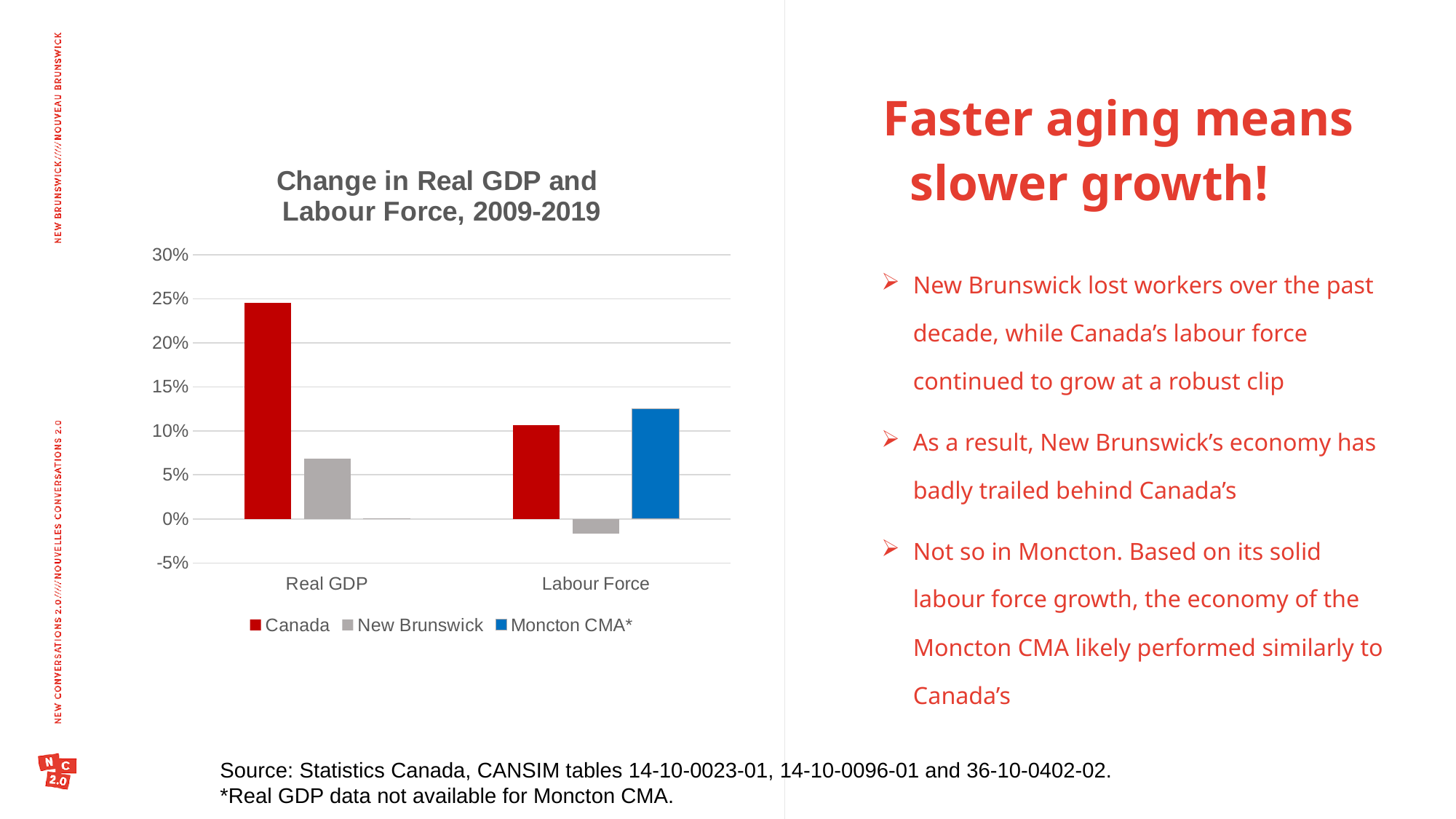
Is the value for Moncton CMA* in Labour Force greater or less than 10%? greater Which series has the lowest value in the Labour Force category? New Brunswick Is the value for New Brunswick in Real GDP greater or less than 10%? less Which series is shown in blue in the chart? Moncton CMA* What kind of chart is shown on the slide? bar chart In the Labour Force category, which is larger: the value for Canada or the value for New Brunswick? Canada How many categories are shown on the x axis of the chart? 2 What is the title of the chart? Change in Real GDP and Labour Force, 2009-2019 How many series does the chart legend list? 3 Which series has the highest value in the Real GDP category? Canada Is the value for Canada in Real GDP greater or less than 20%? greater